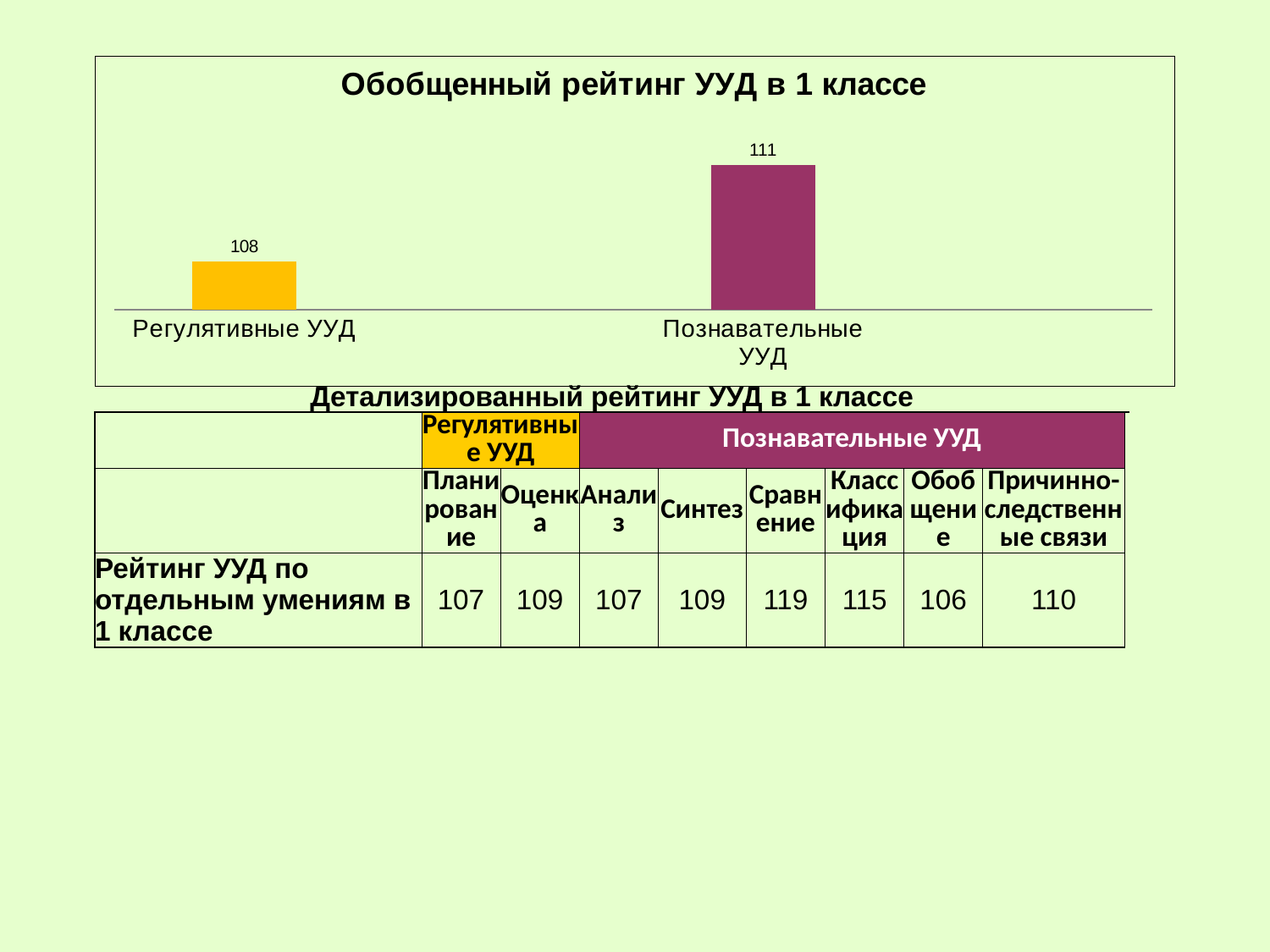
Which category has the highest value in the chart? Познавательные УУД What colour is the bar for Познавательные УУД? Purple What is the value for Регулятивные УУД in the chart? 108 Do the values rise or fall from Регулятивные УУД to Познавательные УУД along the x axis? Rise What is the difference between the values for Познавательные УУД and Регулятивные УУД? 3 What is the value for Познавательные УУД in the chart? 111 Which category has the lowest value in the chart? Регулятивные УУД Which is larger: the value for Регулятивные УУД or the value for Познавательные УУД? Познавательные УУД What is the title of the chart? Обобщенный рейтинг УУД в 1 классе What kind of chart is shown on the slide? Bar chart How many categories are plotted in the chart? 2